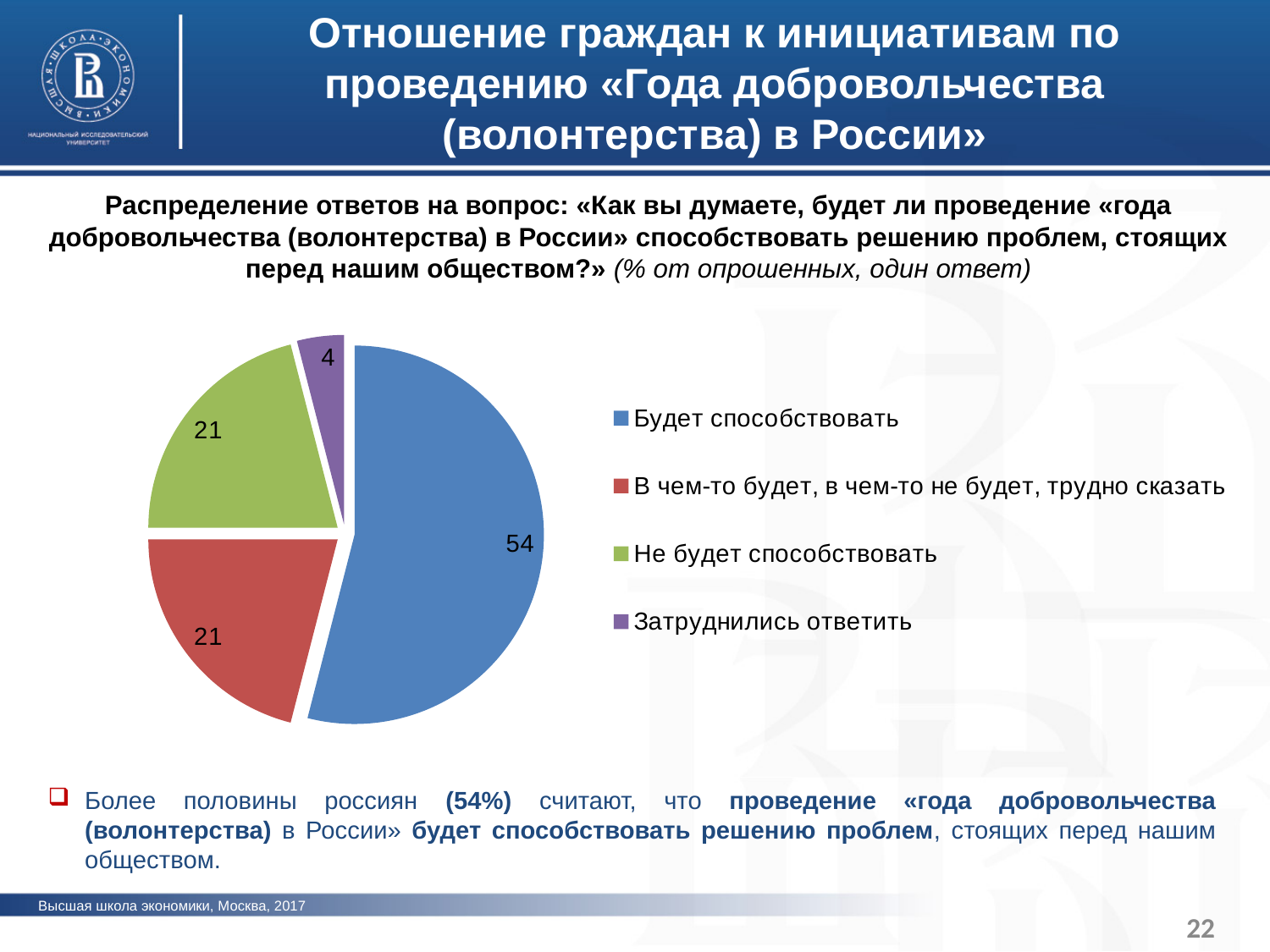
What is the difference between the values for "Будет способствовать" and "Не будет способствовать"? 33 What type of chart is shown on the slide? Pie chart What value is shown for the slice "Не будет способствовать"? 21 Which response category has the largest slice of the pie? Будет способствовать What value is shown for the slice "Затруднились ответить"? 4 Which is larger: the value for "Будет способствовать" or the value for "В чем-то будет, в чем-то не будет, трудно сказать"? Будет способствовать What is the difference between the values for "В чем-то будет, в чем-то не будет, трудно сказать" and "Затруднились ответить"? 17 Which response category has the smallest slice of the pie? Затруднились ответить What value is shown for the slice "Будет способствовать"? 54 What share of respondents answered "Будет способствовать"? 54% How many slices does the pie chart have? 4 What colour represents "Не будет способствовать" in the legend? Green